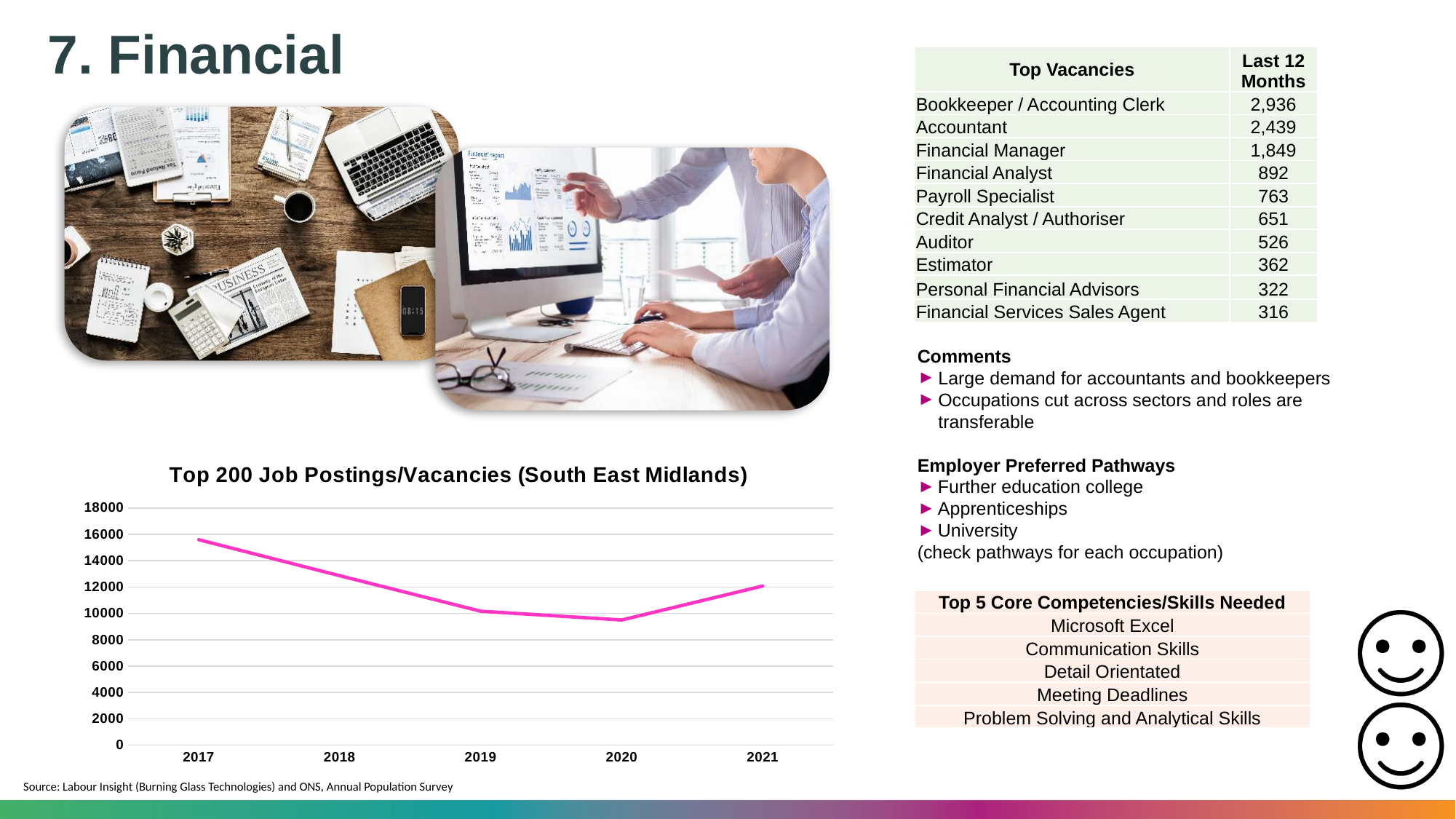
Do the values rise or fall from 2020 to 2021? rise What is the title of the chart? Top 200 Job Postings/Vacancies (South East Midlands) Is the value for 2021 greater or less than 10000? greater Is the value for 2017 greater or less than 14000? greater Is the value for 2018 greater or less than 14000? less How many years are plotted on the x axis of the chart? 5 Which year has the highest value in the chart? 2017 Which is larger, the value for 2018 or the value for 2020? 2018 What kind of chart is shown on the slide? line chart Which is larger, the value for 2017 or the value for 2021? 2017 Do the values rise or fall from 2017 to 2020? fall